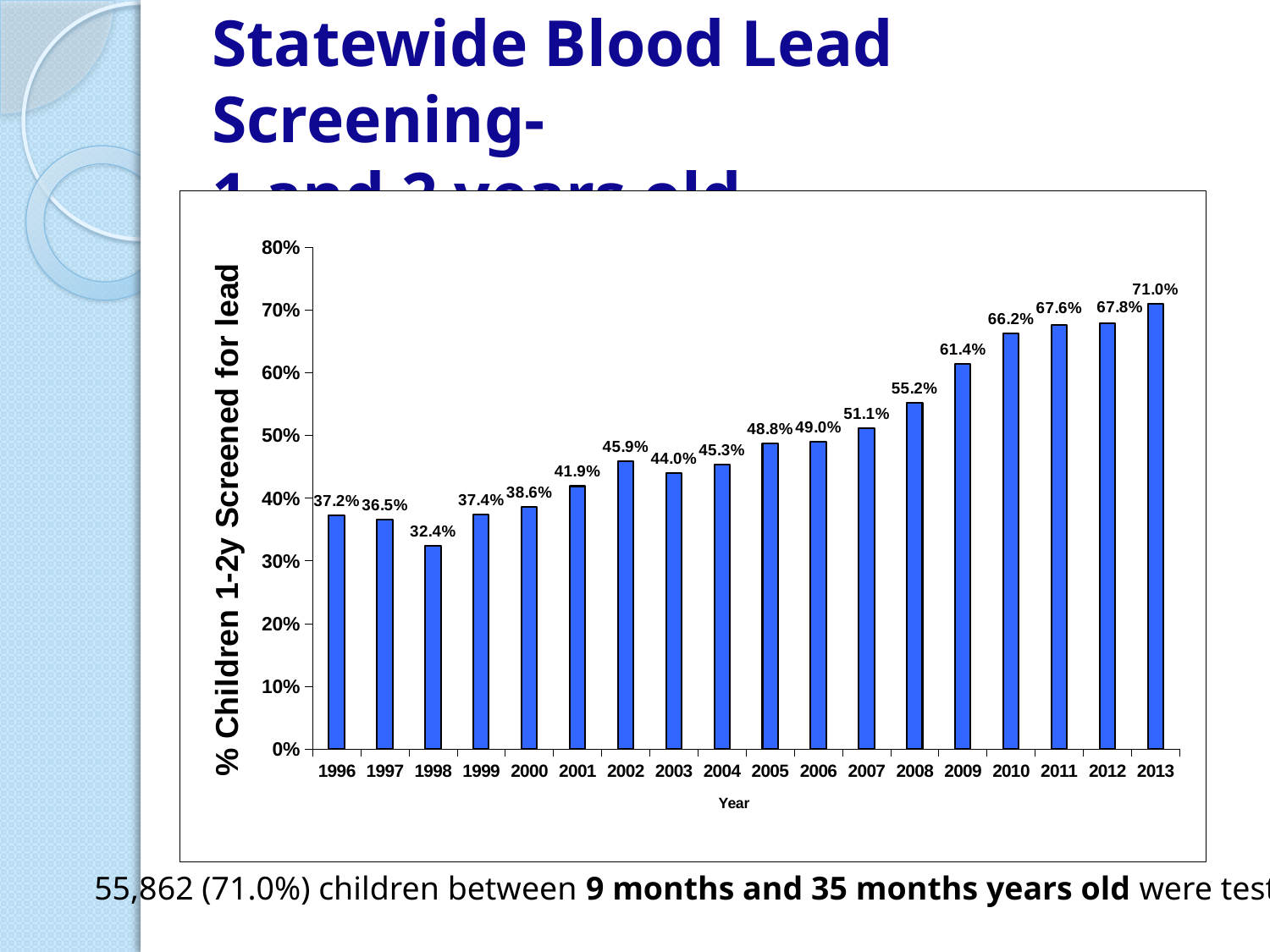
Do the values generally rise or fall from 1996 to 2013? rise What percentage of children 1-2y were screened for lead in 2013? 71.0% Which year has the lowest screening percentage? 1998 What kind of chart is shown on the slide? bar chart What percentage is shown for 2005? 48.8% What is the value shown for 1998? 32.4% Which year has the highest screening percentage? 2013 Is the value for 2007 greater or less than 50%? greater What is the difference between the values for 2013 and 1996? 33.8% Which year has a higher value, 2001 or 2003? 2003 What is the difference between the values for 2009 and 2008? 6.2% How many years are shown on the x axis? 18